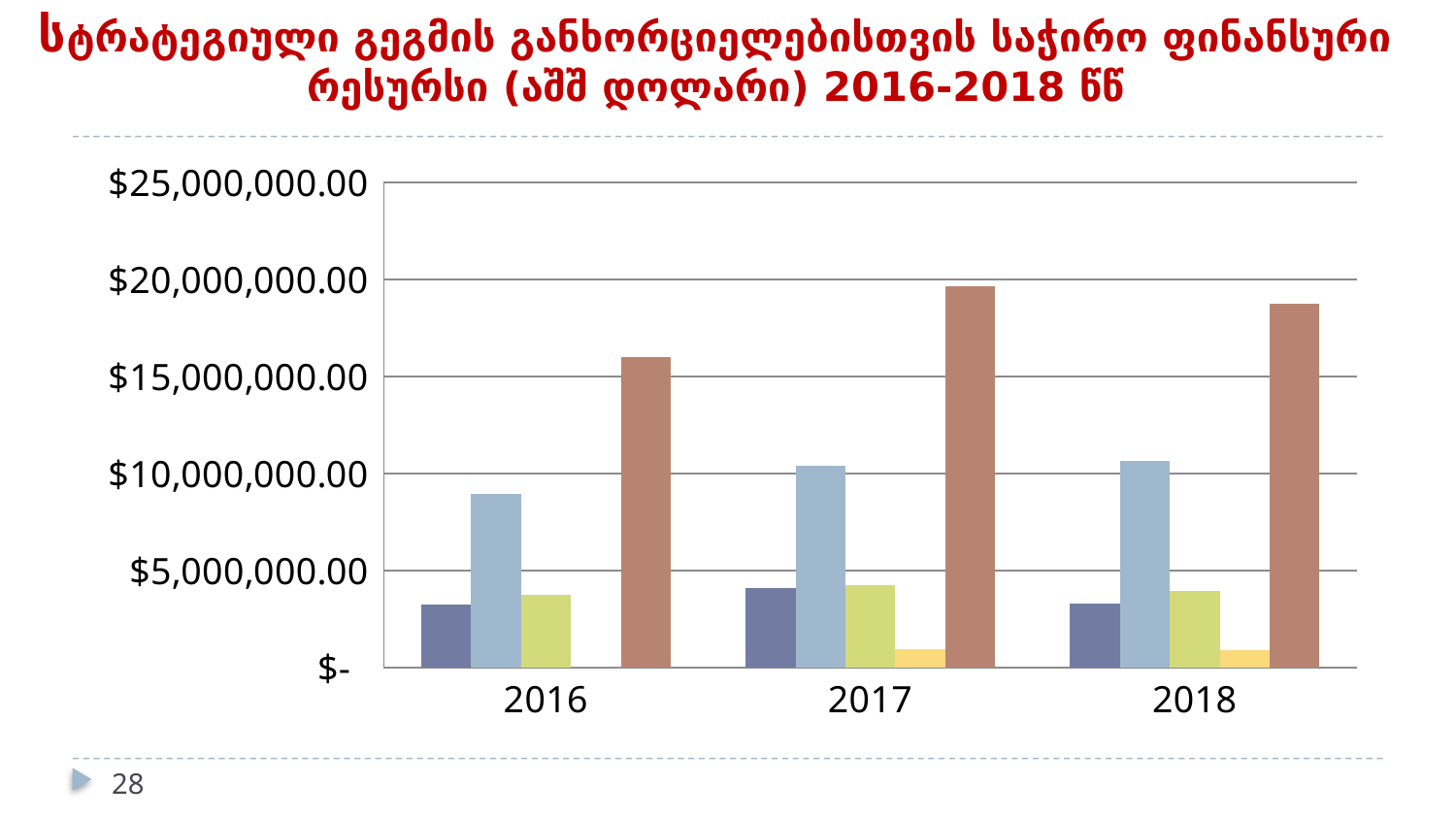
Which is larger, the brown bar for 2017 or the brown bar for 2016? 2017 Which is larger in 2016, the light blue bar or the dark blue bar? the light blue bar What is the highest value shown on the y axis of the chart? $25,000,000.00 How many years are shown on the x axis of the chart? 3 Is the value of the brown bar for 2017 greater or less than $20,000,000.00? less Is the value of the light blue bar for 2016 greater or less than $10,000,000.00? less Is the value of the brown bar for 2016 greater or less than $15,000,000.00? greater What kind of chart is shown on the slide? bar chart Which years are shown on the x axis of the chart? 2016, 2017, 2018 In which year is the brown bar the shortest? 2016 In which year is the brown bar the tallest? 2017